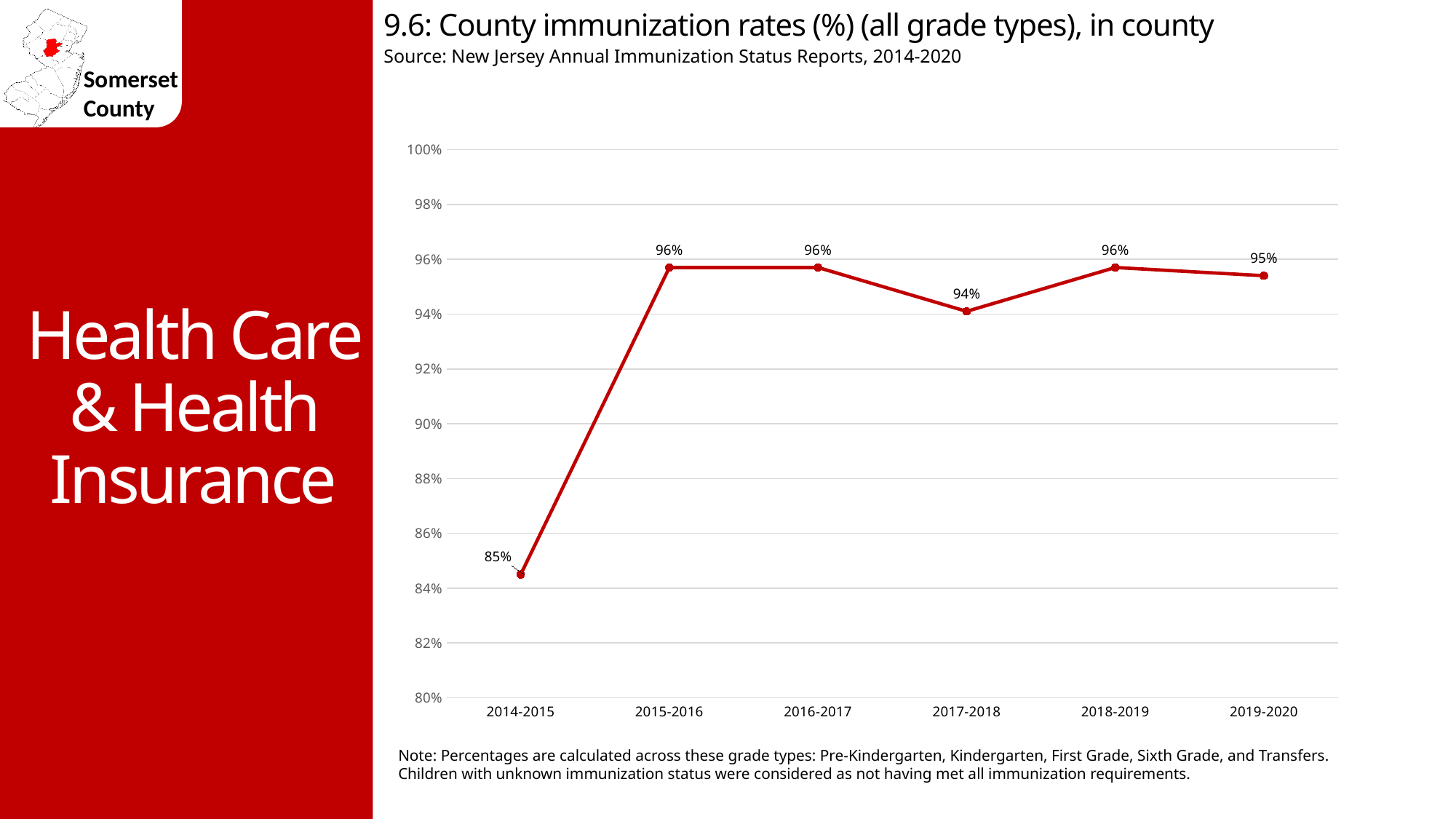
Does the immunization rate rise or fall from 2014-2015 to 2015-2016? rise Which school year has the lowest immunization rate? 2014-2015 What is the source cited for the chart? New Jersey Annual Immunization Status Reports, 2014-2020 What kind of chart is shown on the slide? line chart Is the immunization rate for 2014-2015 greater or less than 90%? less What is the county immunization rate for 2014-2015? 85% What is the difference between the immunization rate in 2015-2016 and in 2014-2015? 11 percentage points How many school years are plotted on the chart? 6 Is the immunization rate for 2017-2018 greater or less than 90%? greater What is the county immunization rate for 2017-2018? 94% What is the county immunization rate for 2019-2020? 95% Which has the higher immunization rate, 2017-2018 or 2018-2019? 2018-2019